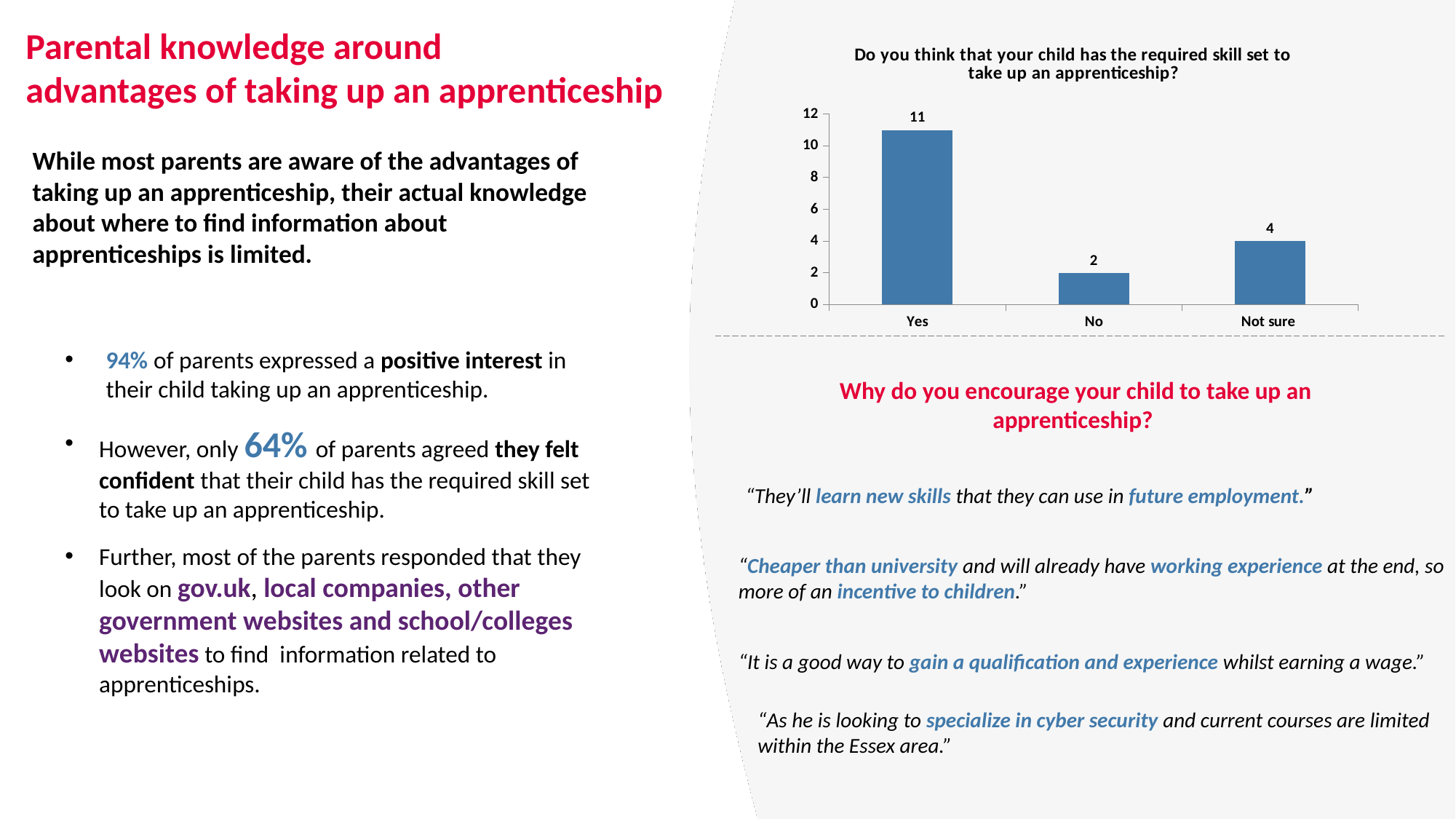
What is the value shown for the "Not sure" category in the chart? 4 What is the difference between the "Yes" and "Not sure" values in the chart? 7 What is the difference between the "Not sure" and "No" values in the chart? 2 Is the value for "Yes" in the chart greater or less than 10? greater What is the value shown for the "No" category in the chart? 2 How many parents answered "Yes" to whether their child has the required skill set to take up an apprenticeship? 11 Which category has the highest value in the chart? Yes Which is larger in the chart, the value for "No" or the value for "Not sure"? Not sure What kind of chart is shown on the slide? Bar chart What is the title of the chart on the slide? Do you think that your child has the required skill set to take up an apprenticeship? Which category has the lowest value in the chart? No How many categories are shown on the x axis of the chart? 3